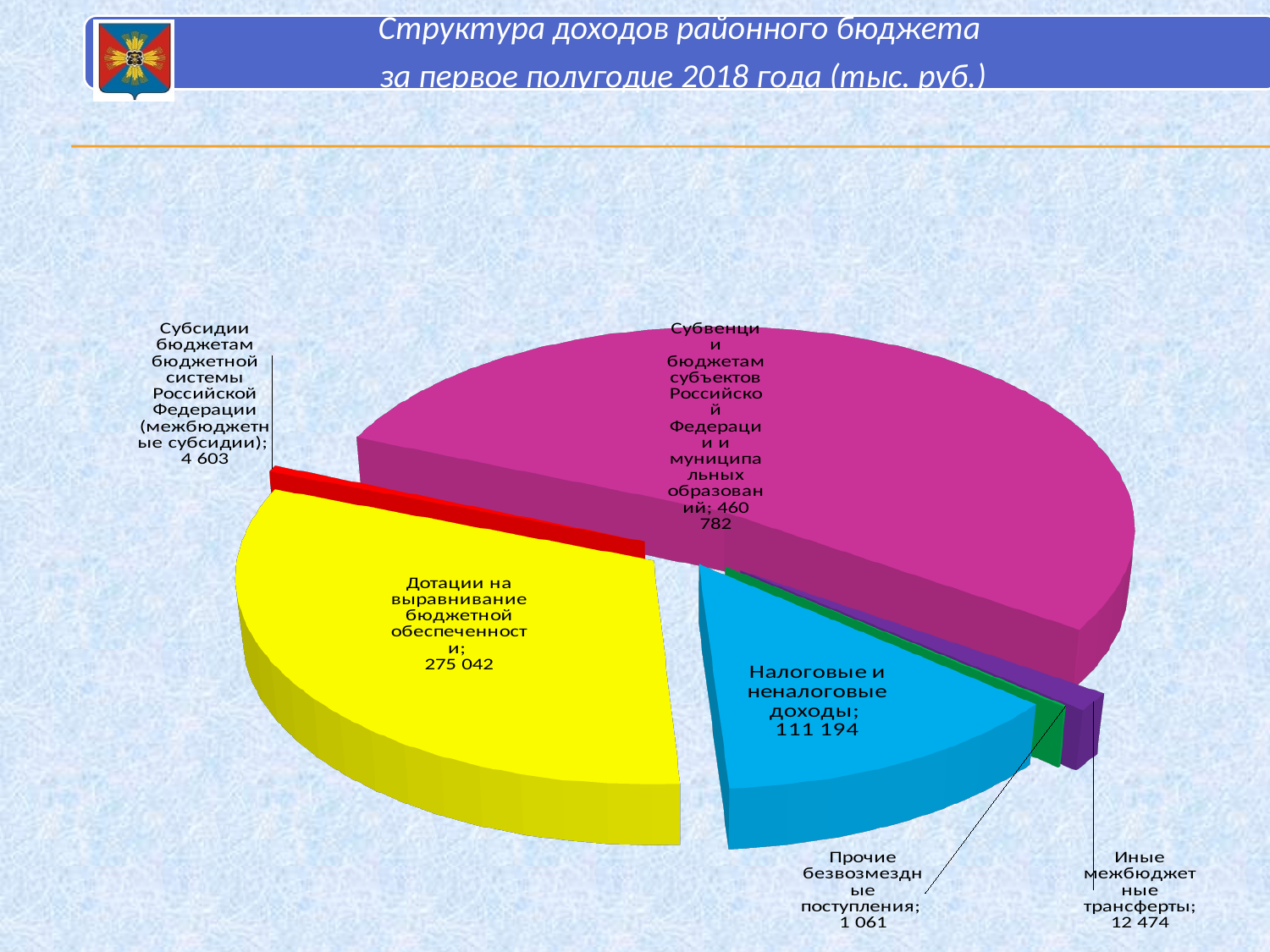
What is the difference between Иные межбюджетные трансферты and Субсидии бюджетам бюджетной системы Российской Федерации (межбюджетные субсидии)? 7 871 What kind of chart is shown on the slide? pie chart What is the value for Дотации на выравнивание бюджетной обеспеченности? 275 042 What is the difference between the values for Субвенции (460 782) and Дотации на выравнивание бюджетной обеспеченности (275 042)? 185 740 What is the value for Прочие безвозмездные поступления? 1 061 How many slices does the pie chart have? 6 What is the title of the chart on the slide? Структура доходов районного бюджета за первое полугодие 2018 года (тыс. руб.) What is the value for Налоговые и неналоговые доходы? 111 194 Which category has the largest value? Субвенции бюджетам субъектов Российской Федерации и муниципальных образований Which is larger: Налоговые и неналоговые доходы or Иные межбюджетные трансферты? Налоговые и неналоговые доходы What is the value for Иные межбюджетные трансферты? 12 474 Which category has the smallest value? Прочие безвозмездные поступления